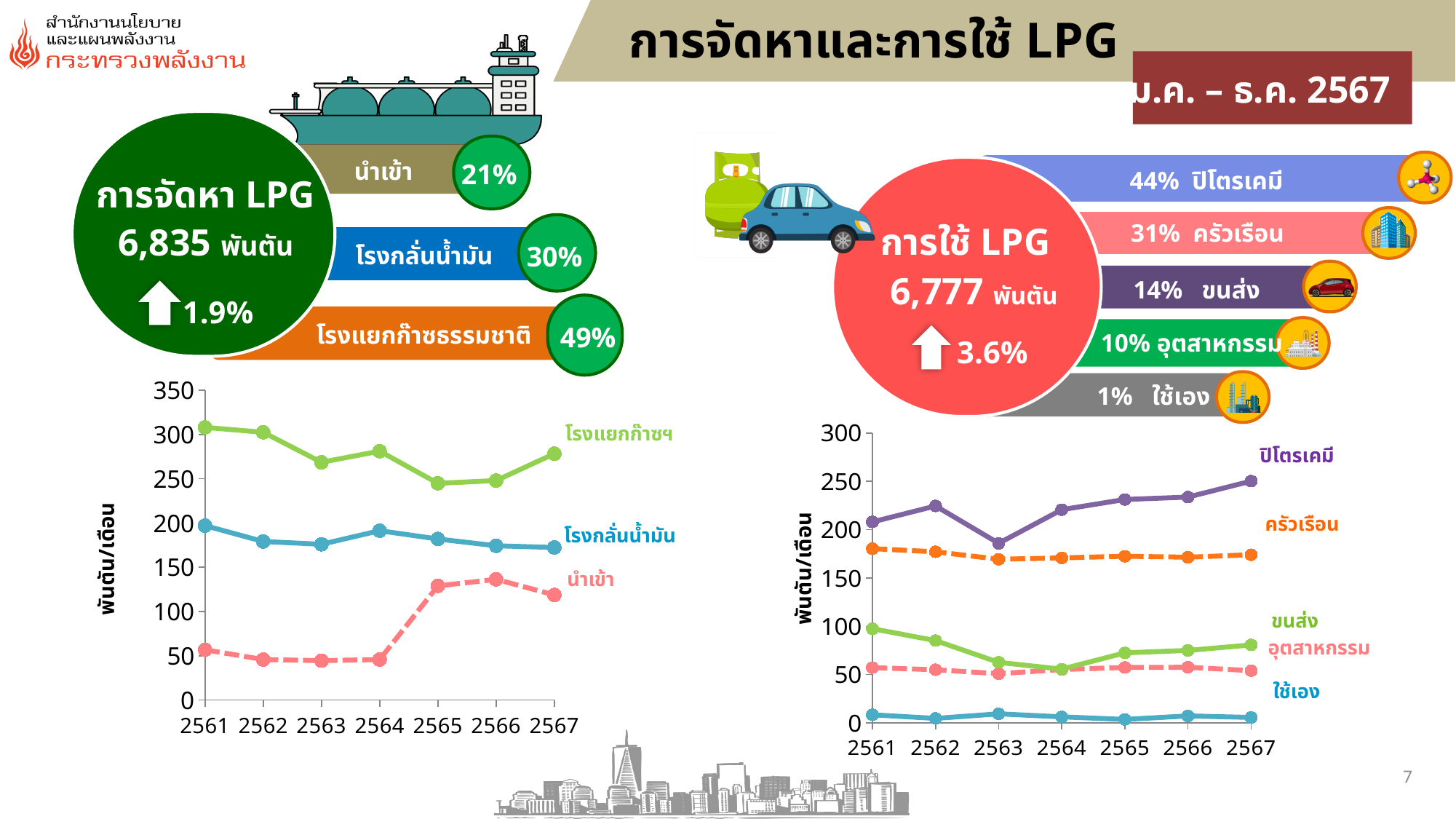
On the left chart, how many series are plotted? 3 On the right chart, how many series are plotted? 5 On the right chart, is the value for ปิโตรเคมี in 2567 greater or less than 200? greater On the left chart, does the นำเข้า line rise or fall from 2564 to 2565? rise On the left chart, is the value for นำเข้า in 2566 greater or less than 100? greater On the left chart, is the value for นำเข้า in 2561 greater or less than 100? less On the left chart, how many years are shown on the x axis? 7 What kind of chart is the left chart (พันตัน/เดือน, 2561–2567)? line chart On the left chart, which series has the highest value in 2561? โรงแยกก๊าซฯ On the right chart, which series has the highest value in 2567? ปิโตรเคมี On the left chart, which series has the lowest value in 2561? นำเข้า On the right chart, which is larger in 2561: ขนส่ง or อุตสาหกรรม? ขนส่ง